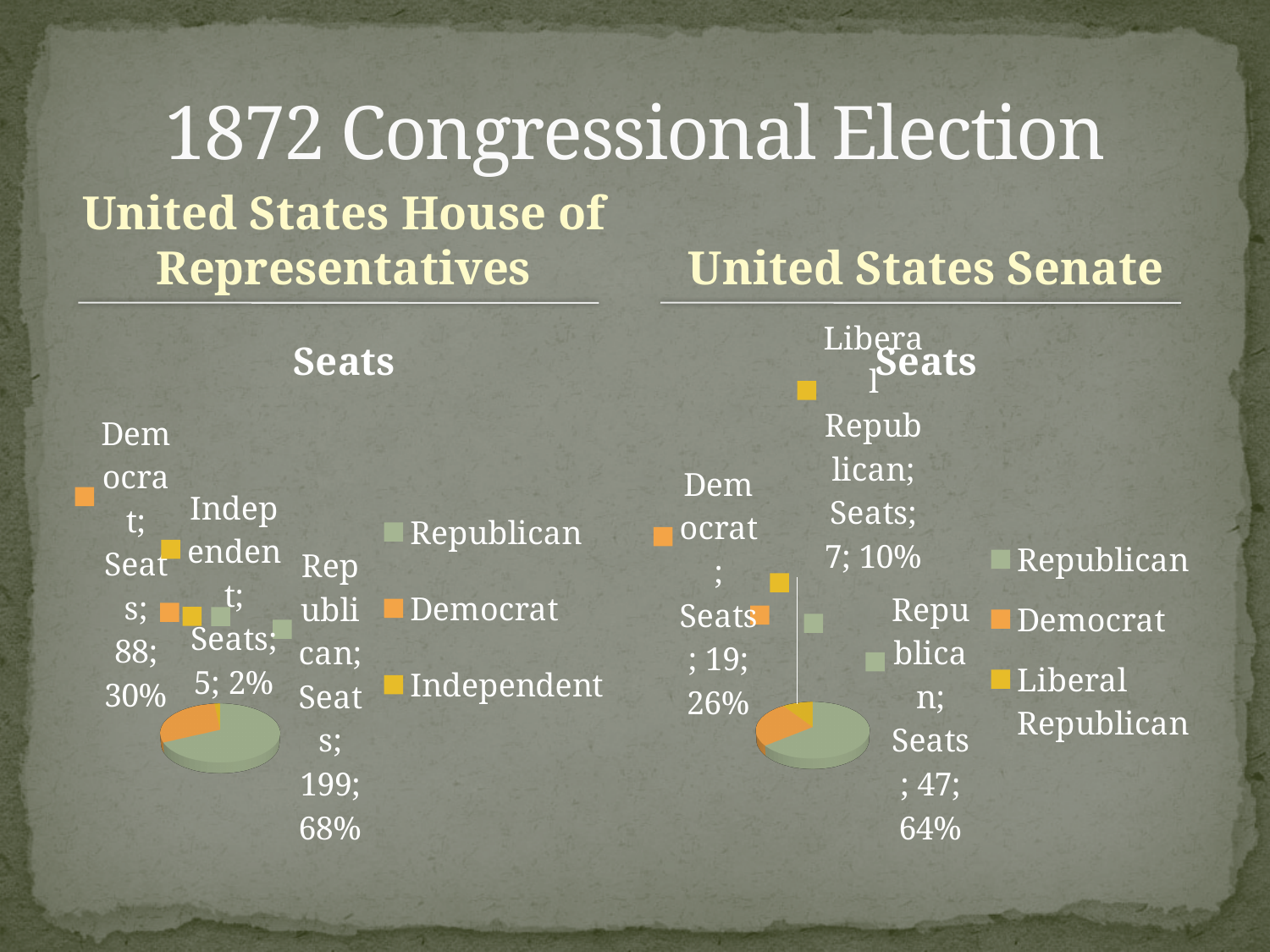
How many entries does the legend of the United States Senate chart list? 3 In the United States Senate chart, how many seats does the Democrat slice show? 19 In the United States House of Representatives chart, how many seats does the Independent slice show? 5 In the United States House of Representatives chart, what is the difference in seats between Republican and Democrat? 111 In the United States Senate chart, what percentage share does the Liberal Republican slice have? 10% In the United States Senate chart, what is the difference in seats between Democrat and Liberal Republican? 12 In the United States House of Representatives chart, what percentage share does the Democrat slice have? 30% In the United States House of Representatives chart, which party has the largest slice? Republican In the United States House of Representatives chart, which party has the smallest slice? Independent What kind of chart is used for the United States House of Representatives seats? Pie chart In the United States House of Representatives chart, how many seats does the Republican slice show? 199 In the United States Senate chart, which party has the largest slice? Republican